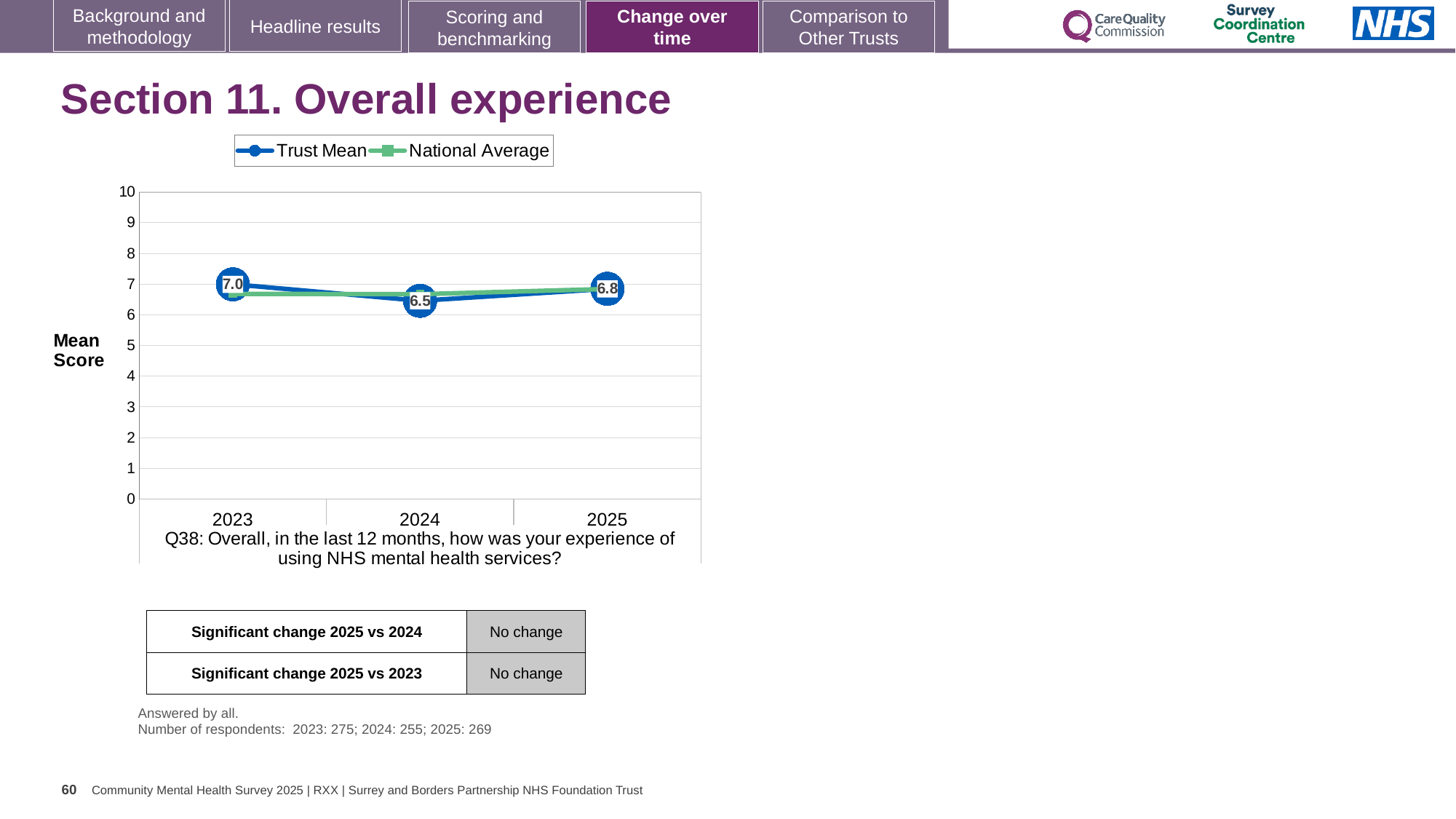
Is the National Average value for 2023 greater or less than 5? greater What kind of chart is shown on the slide? line chart What is the Trust Mean score for 2024? 6.5 Does the Trust Mean score rise or fall from 2024 to 2025? rise Which is larger, the Trust Mean score for 2025 or for 2024? 2025 What is the Trust Mean score for 2025? 6.8 What is the Trust Mean score for 2023? 7.0 In which year is the Trust Mean score highest? 2023 In which year is the Trust Mean score lowest? 2024 What is the difference between the Trust Mean scores for 2023 and 2024? 0.5 How many years are plotted on the x axis? 3 How many series does the legend list? 2